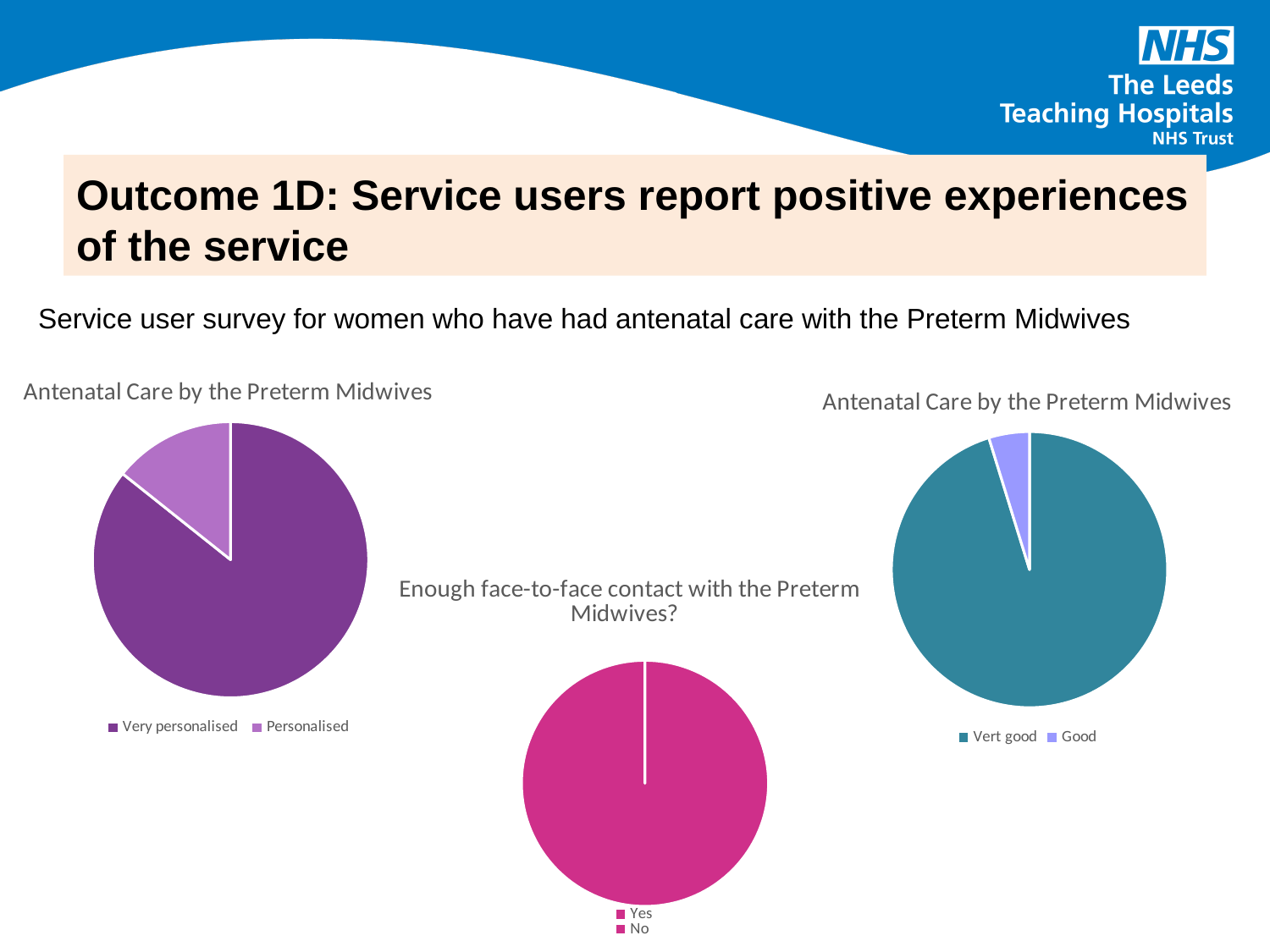
How many entries does the legend of the middle pie chart list? 2 In the middle pie chart, which category has the largest slice? Yes What kind of chart is the left-hand chart titled 'Antenatal Care by the Preterm Midwives'? Pie chart How many pie charts are shown on the slide? 3 In the left-hand pie chart, which slice is larger: 'Very personalised' or 'Personalised'? Very personalised How many entries does the legend of the left-hand pie chart list? 2 In the middle pie chart, which slice is larger: 'Yes' or 'No'? Yes In the right-hand pie chart, which slice is smaller: 'Vert good' or 'Good'? Good In the left-hand pie chart, which category has the smallest slice? Personalised In the right-hand pie chart, which category has the largest slice? Vert good In the left-hand pie chart, which category has the largest slice? Very personalised What is the title of the middle chart? Enough face-to-face contact with the Preterm Midwives?